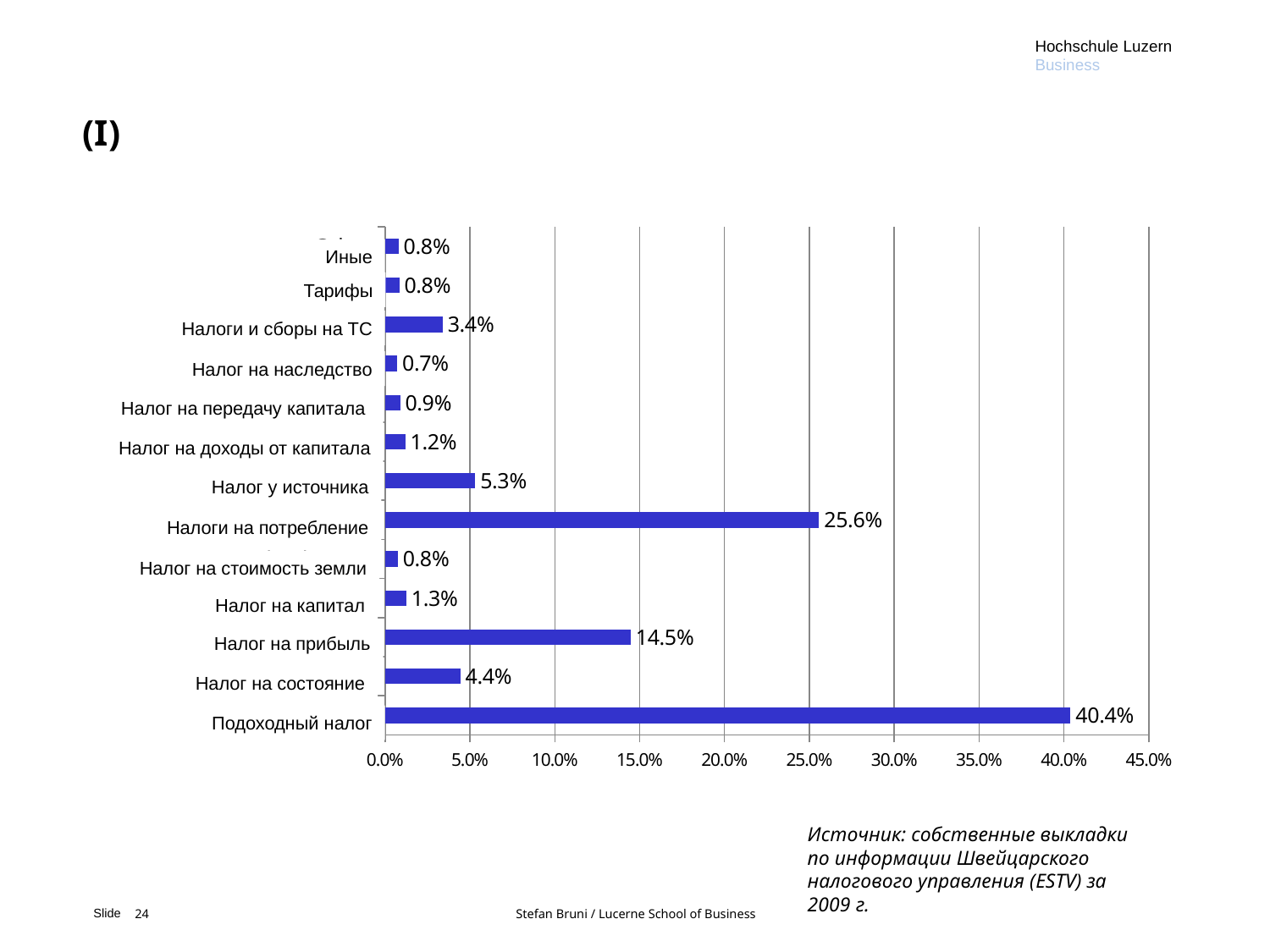
What is the value for Налог на наследство? 0.7% What is the difference between Подоходный налог and Налоги на потребление? 14.8% What is the value for Подоходный налог? 40.4% Which category has the highest value? Подоходный налог What is the value for Налог на прибыль? 14.5% What is the value for Налог у источника? 5.3% Which category has the lowest value? Налог на наследство What kind of chart is shown on the slide? bar chart What is the value for Налоги на потребление? 25.6% Is the value for Налоги на потребление greater or less than 20.0%? greater Which is larger, Налог на прибыль or Налог на состояние? Налог на прибыль How many categories are shown in the chart? 13